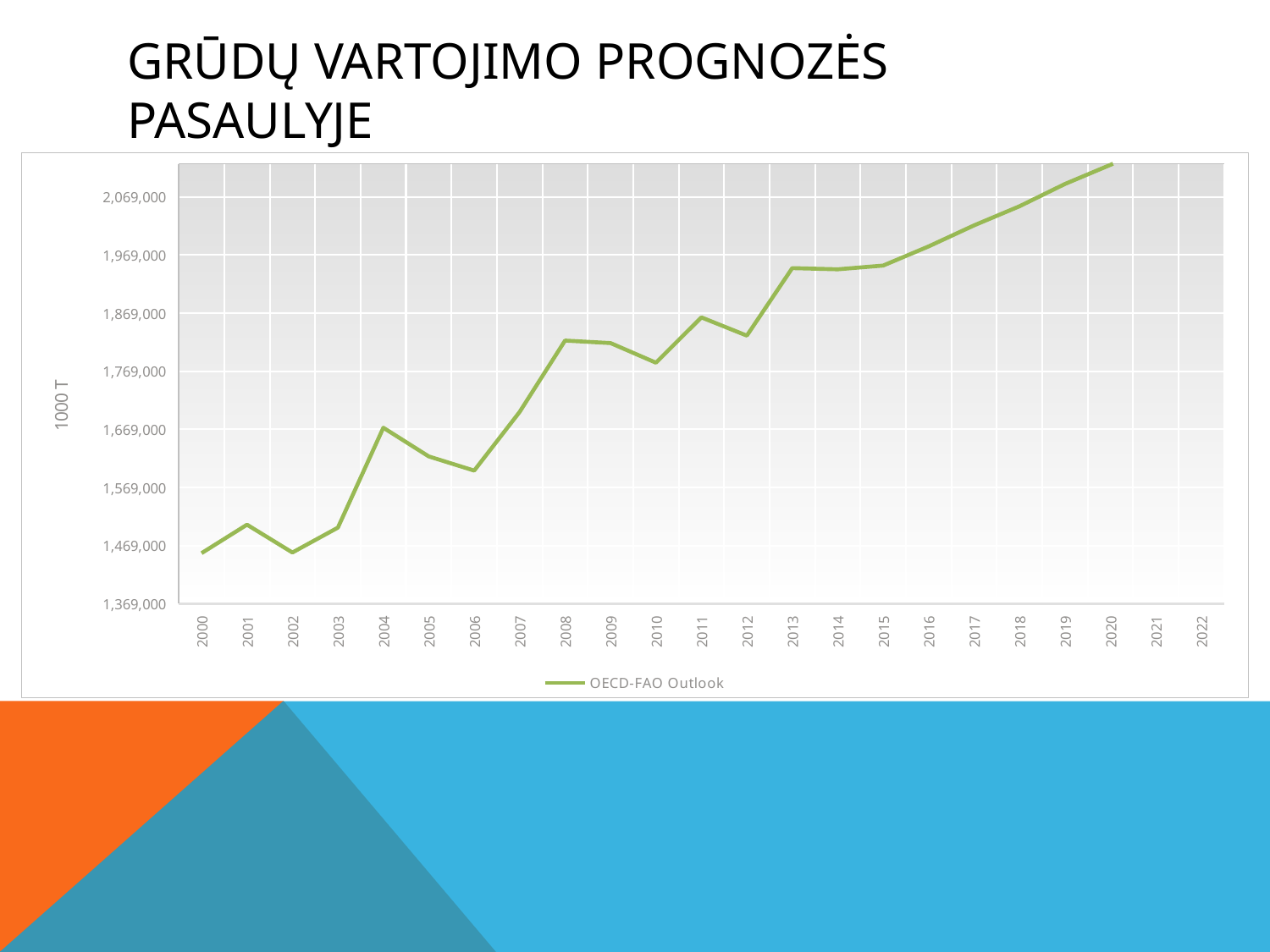
How many series does the legend list? 1 What kind of chart is shown on the slide? line chart Which year has the larger value, 2011 or 2012? 2011 What is the label on the vertical axis? 1000 T What is the name of the series shown in the legend? OECD-FAO Outlook Overall, do the values rise or fall from 2000 to 2020? rise Which year has the highest value for OECD-FAO Outlook? 2020 Is the value for 2020 greater or less than 2,069,000? greater Is the value for 2008 greater or less than 1,769,000? greater Is the value for 2013 greater or less than 1,969,000? less How many years are labelled on the x axis? 23 Which year has the larger value, 2004 or 2006? 2004